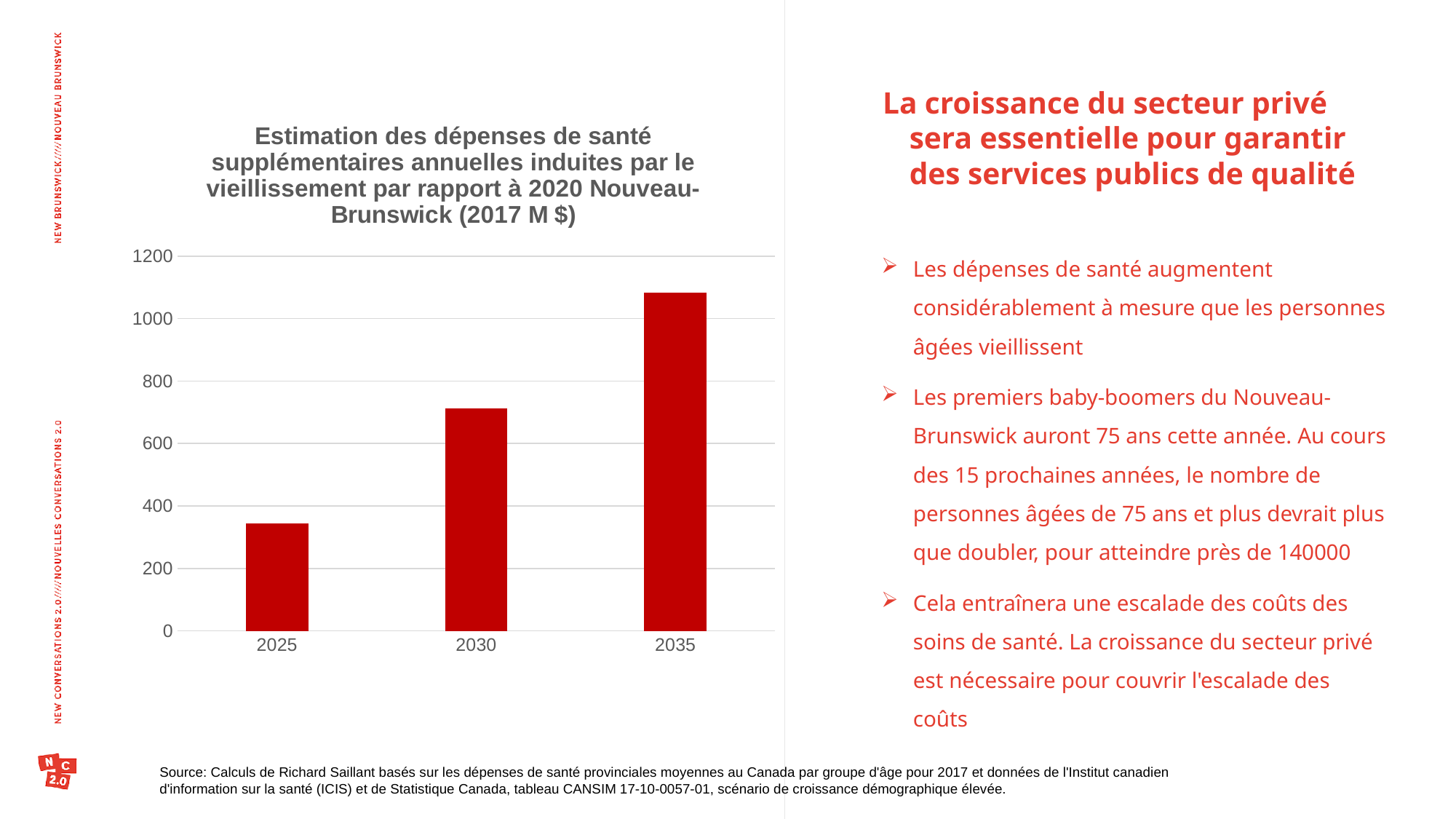
What kind of chart is shown on the slide? bar chart Is the value for 2030 greater or less than 600? greater Which year has the highest estimated additional health spending? 2035 Is the value for 2030 greater or less than 800? less Do the values rise or fall from 2025 to 2035? rise Which is larger, the value for 2030 or the value for 2035? 2035 Is the value for 2025 greater or less than 200? greater What is the highest value shown on the vertical axis of the chart? 1200 Which year has the lowest estimated additional health spending? 2025 How many years (categories) are plotted on the chart? 3